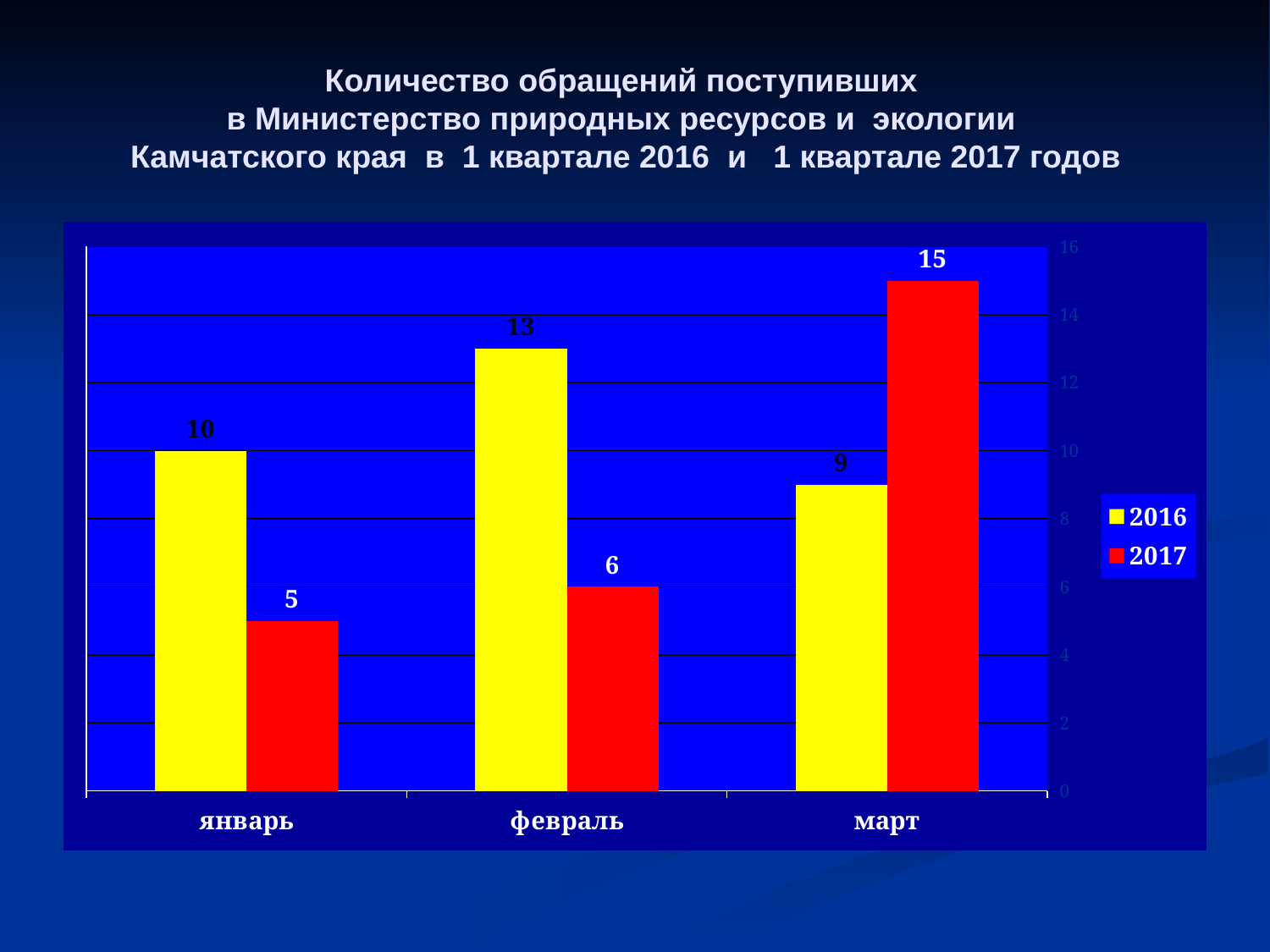
How many months are shown on the x axis? 3 What is the value for 2016 in январь? 10 What is the value for 2017 in февраль? 6 Do the values for the 2017 series rise or fall from январь to март? rise What is the value for 2017 in март? 15 What kind of chart is shown on the slide? bar chart Which month has the lowest value for the 2017 series? январь Which month has the highest value for the 2016 series? февраль How many series does the legend list? 2 What is the difference between the 2017 and 2016 values in март? 6 What is the difference between the 2016 and 2017 values in январь? 5 Which is larger in февраль: the 2016 value or the 2017 value? 2016